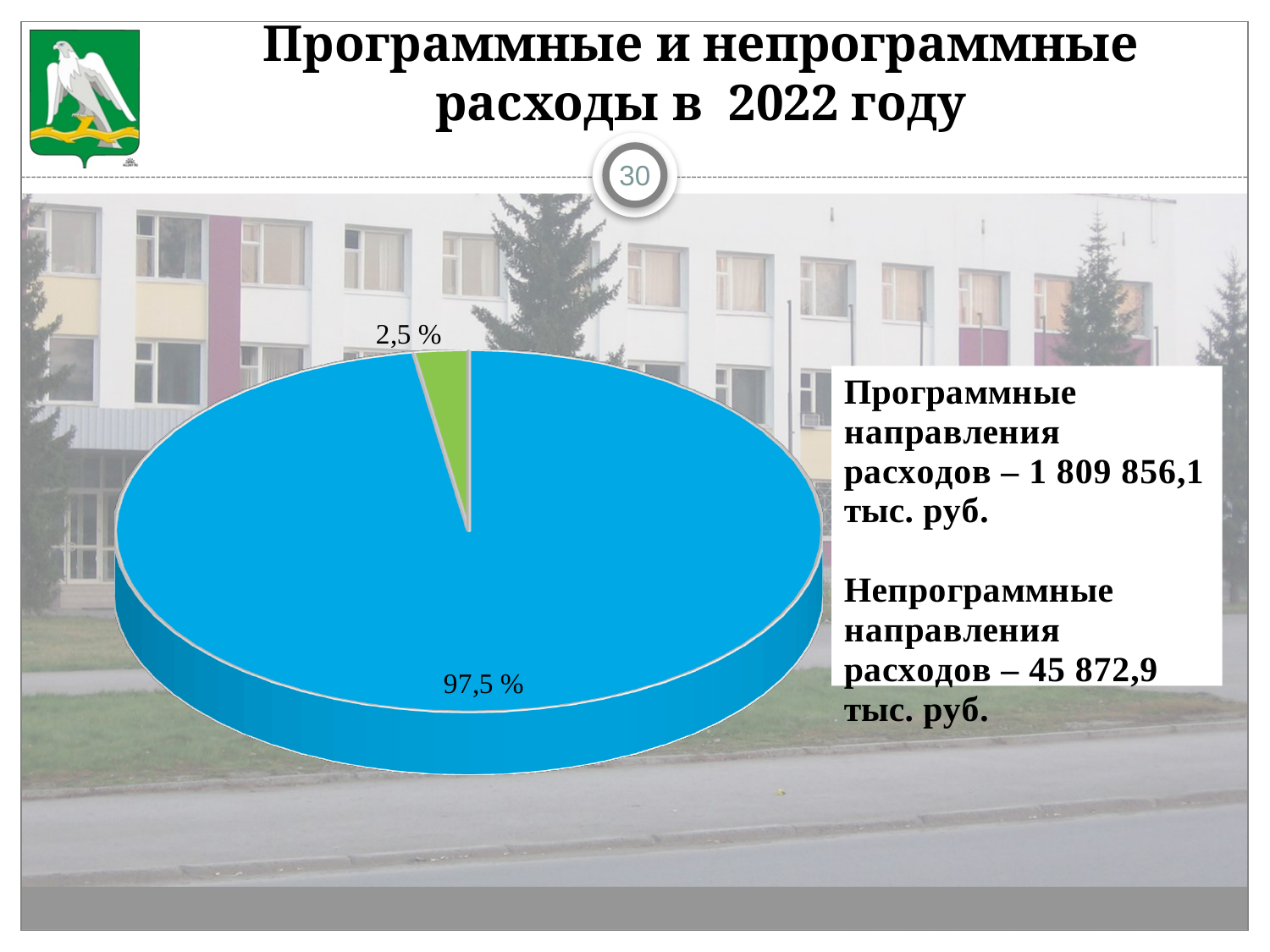
Which slice is larger, the blue one or the green one? the blue one Which slice is the smallest in the pie chart? 2,5 % (green slice) What share of the pie does the smaller (green) slice represent? 2,5 % How many slices does the pie chart have? 2 What is the difference in percentage points between the two slices of the pie chart? 95 percentage points What is the title of the slide containing the pie chart? Программные и непрограммные расходы в 2022 году According to the text next to the chart, what is the amount of программные направления расходов? 1 809 856,1 тыс. руб. Which slice is the largest in the pie chart? 97,5 % (blue slice) Is the share of the green slice greater or less than 50%? less What share of the pie does the larger (blue) slice represent? 97,5 % What kind of chart is shown on the slide? pie chart According to the text next to the chart, what is the amount of непрограммные направления расходов? 45 872,9 тыс. руб.